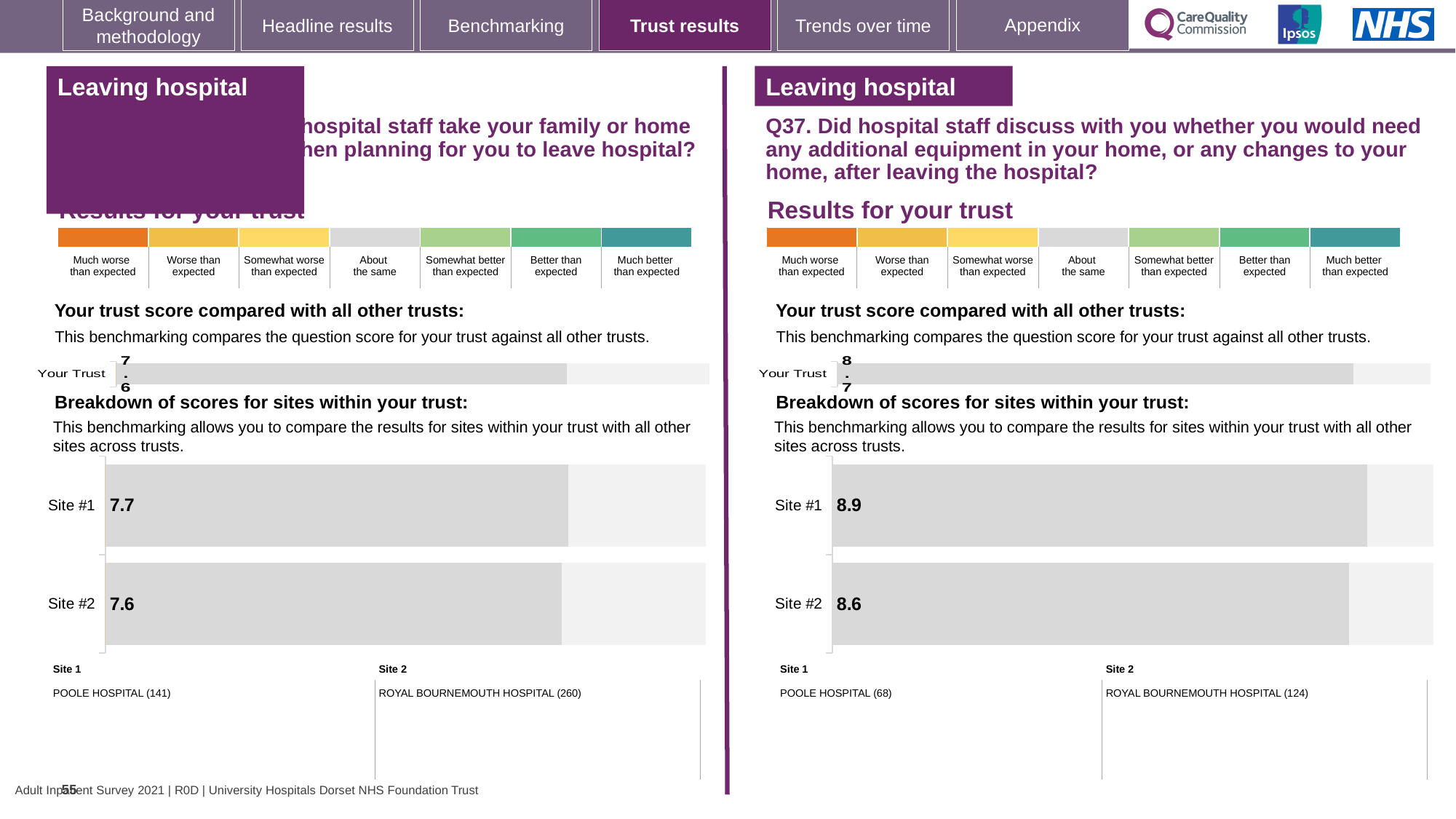
What type of chart is used to show the breakdown of scores for sites on the right-hand side (Q37)? bar chart On the left-hand chart, what is the 'Your Trust' score? 7.6 On the right-hand chart (Q37), what is the difference between the Site #1 and Site #2 scores? 0.3 On the left-hand chart, what is the score for Site #1? 7.7 How many sites are shown in the site breakdown chart on the right-hand side (Q37)? 2 On the right-hand chart (Q37), what is the score for Site #2? 8.6 On the right-hand chart (Q37), what is the score for Site #1? 8.9 On the left-hand chart, what is the difference between the Site #1 and Site #2 scores? 0.1 Is the Site #1 score on the right-hand chart (Q37) larger or smaller than the Site #1 score on the left-hand chart? larger On the right-hand chart (Q37), which site has the higher score? Site #1 On the left-hand chart, what is the score for Site #2? 7.6 On the right-hand chart (Q37), what is the 'Your Trust' score? 8.7